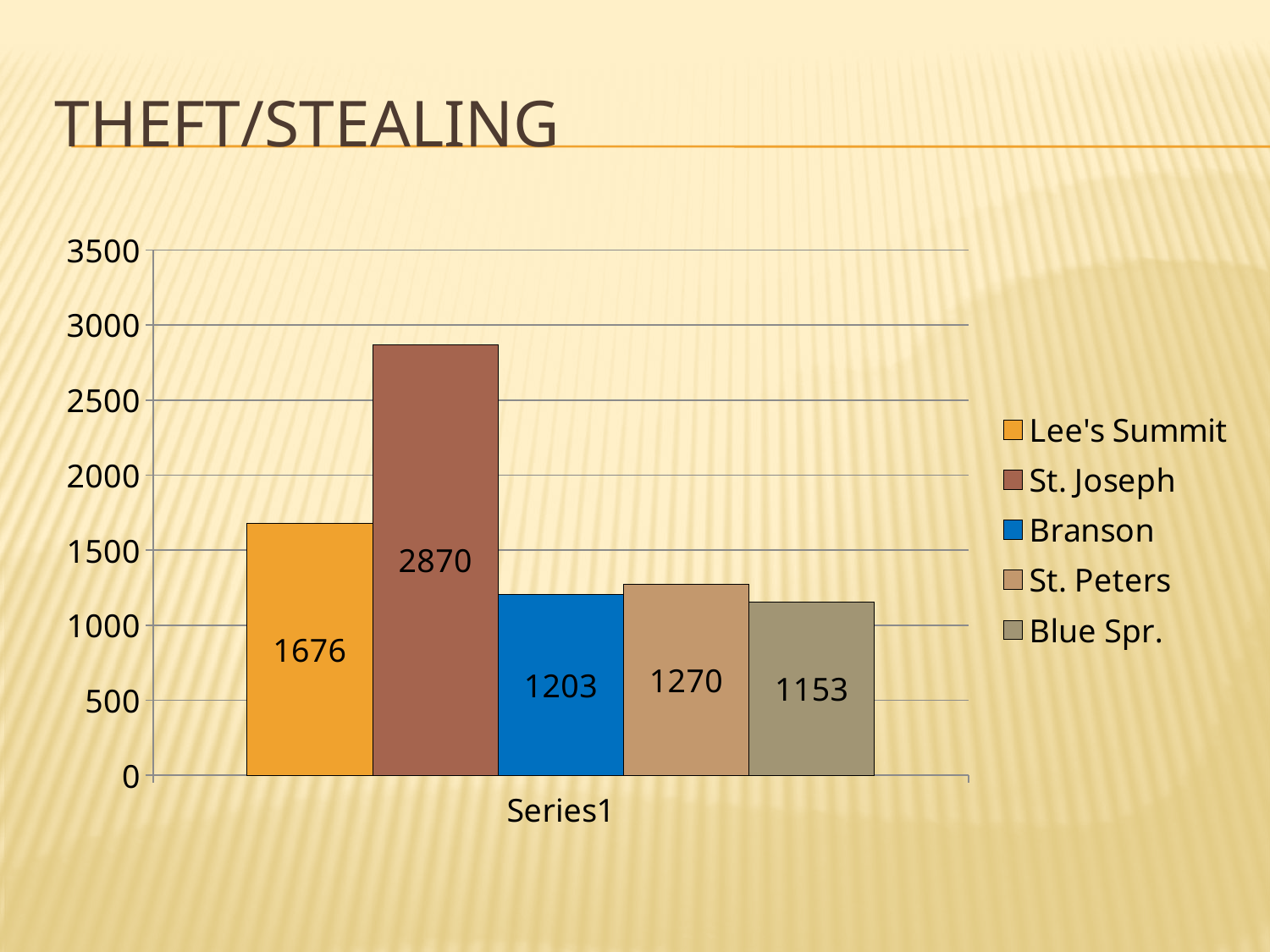
What is the value for St. Joseph? 2870 What kind of chart is shown on the slide? bar chart What is the title of the slide? THEFT/STEALING What is the difference between the values for St. Joseph and Lee's Summit? 1194 Is the value for St. Joseph greater or less than 2500? greater Which is larger, the value for Lee's Summit or the value for St. Peters? Lee's Summit What is the value for Lee's Summit? 1676 What is the value for Blue Spr.? 1153 How many cities are shown in the chart? 5 Which city has the highest value? St. Joseph What is the difference between the values for St. Peters and Branson? 67 Which city has the lowest value? Blue Spr.